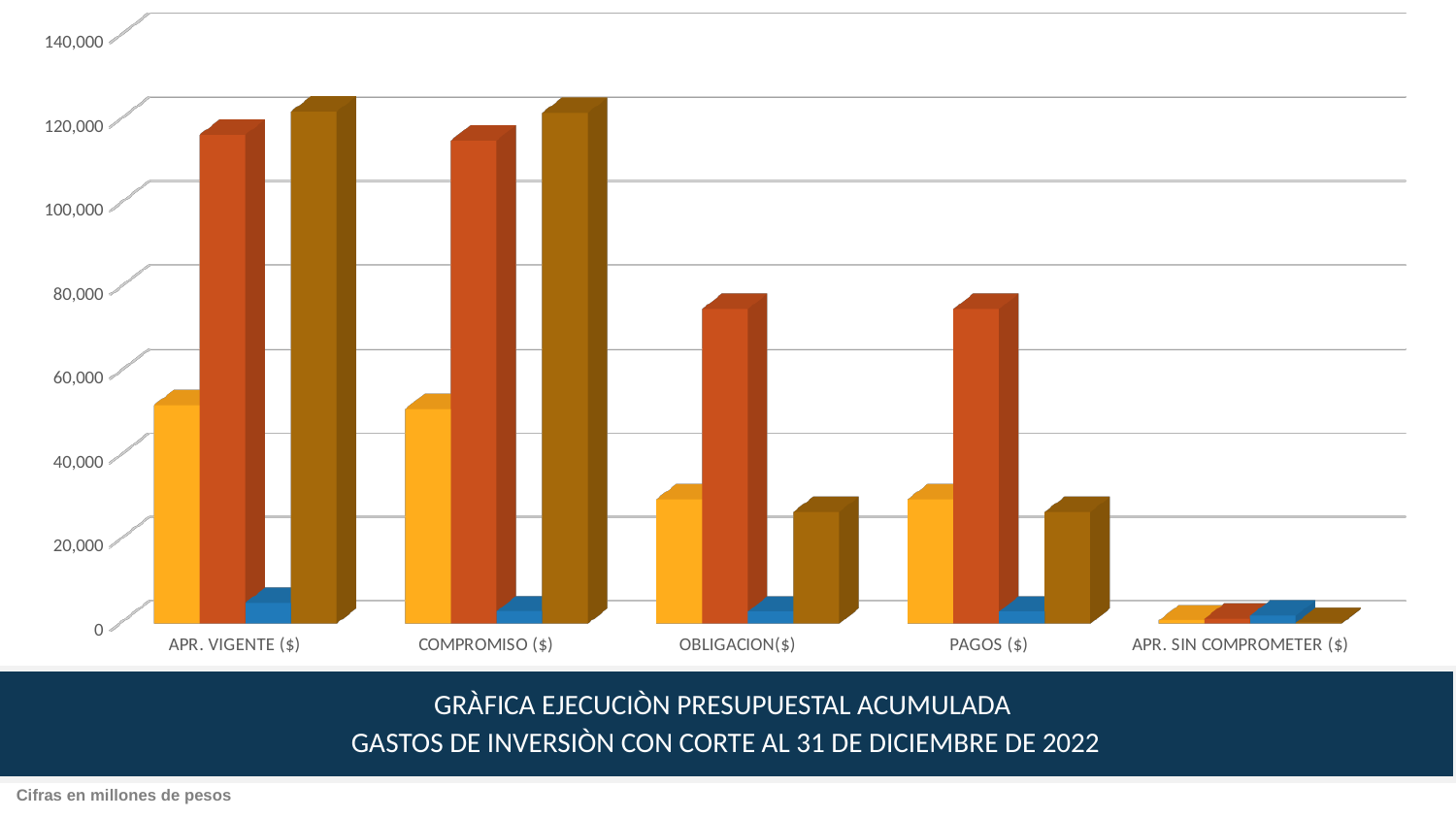
Is the value of the yellow bar for APR. VIGENTE ($) greater or less than 40,000? greater According to the note below the chart, in what units are the figures expressed? millones de pesos Which is larger: the red bar for APR. VIGENTE ($) or the red bar for OBLIGACION($)? APR. VIGENTE ($) Is the value of the red bar for PAGOS ($) greater or less than 60,000? greater Is the value of the blue bar for COMPROMISO ($) greater or less than 20,000? less Which category has the lowest bars overall in the chart? APR. SIN COMPROMETER ($) How many categories are shown on the x axis of the chart? 5 What is the highest value shown on the vertical axis of the chart? 140,000 What kind of chart is shown on the slide? bar chart How many bars are plotted for each category in the chart? 4